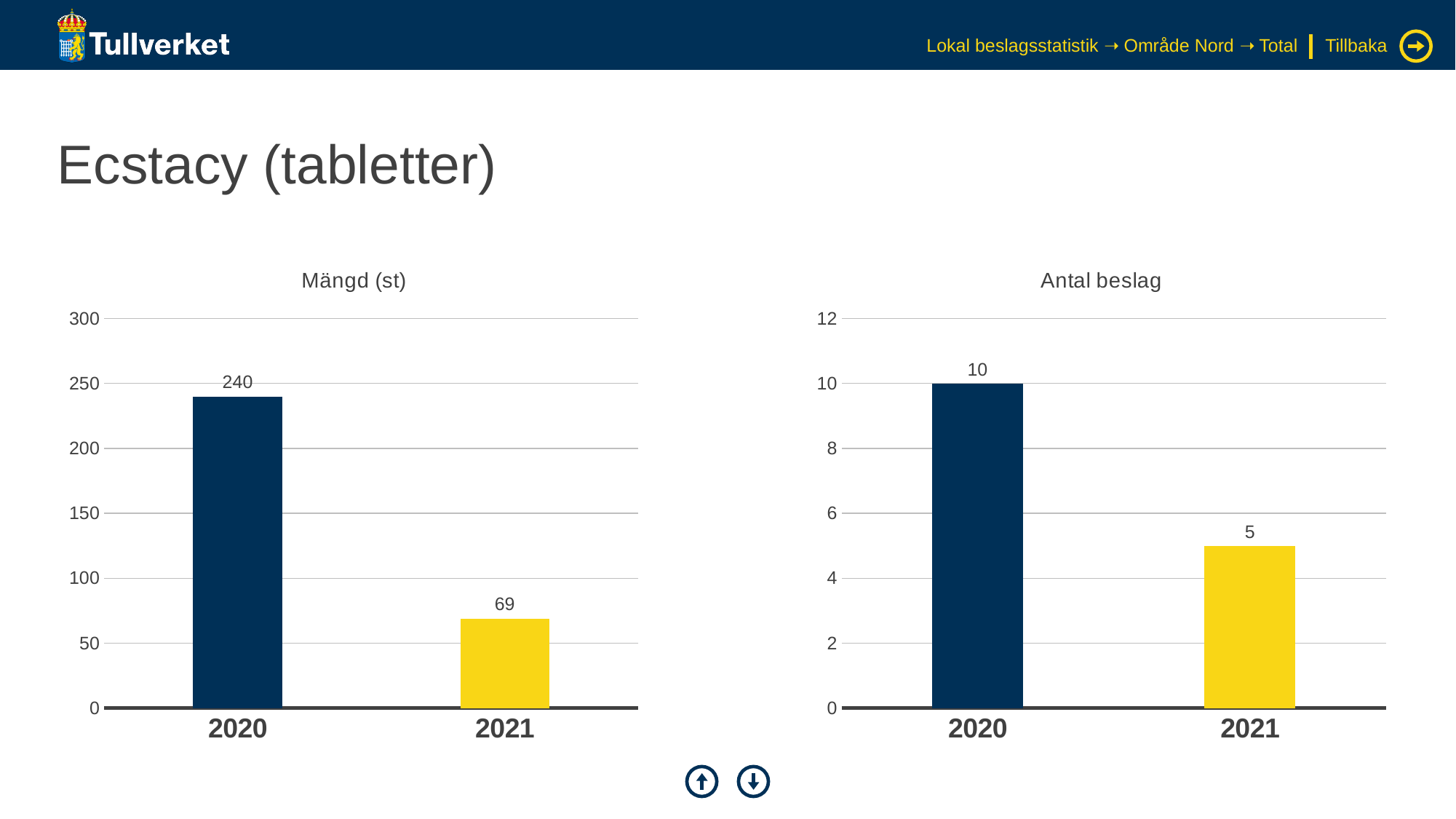
In the 'Antal beslag' chart, which is larger, the value for 2020 or 2021? 2020 In the 'Mängd (st)' chart, what is the value for 2020? 240 What kind of chart is the 'Antal beslag' chart? bar chart In the 'Mängd (st)' chart, what is the difference between the values for 2020 and 2021? 171 In the 'Mängd (st)' chart, do the values rise or fall from 2020 to 2021? fall In the 'Antal beslag' chart, which year has the lowest value? 2021 How many categories are shown on the x axis of the 'Mängd (st)' chart? 2 In the 'Antal beslag' chart, what is the value for 2020? 10 In the 'Antal beslag' chart, what is the difference between the values for 2020 and 2021? 5 In the 'Mängd (st)' chart, which year has the highest value? 2020 In the 'Mängd (st)' chart, what is the value for 2021? 69 In the 'Antal beslag' chart, what is the value for 2021? 5